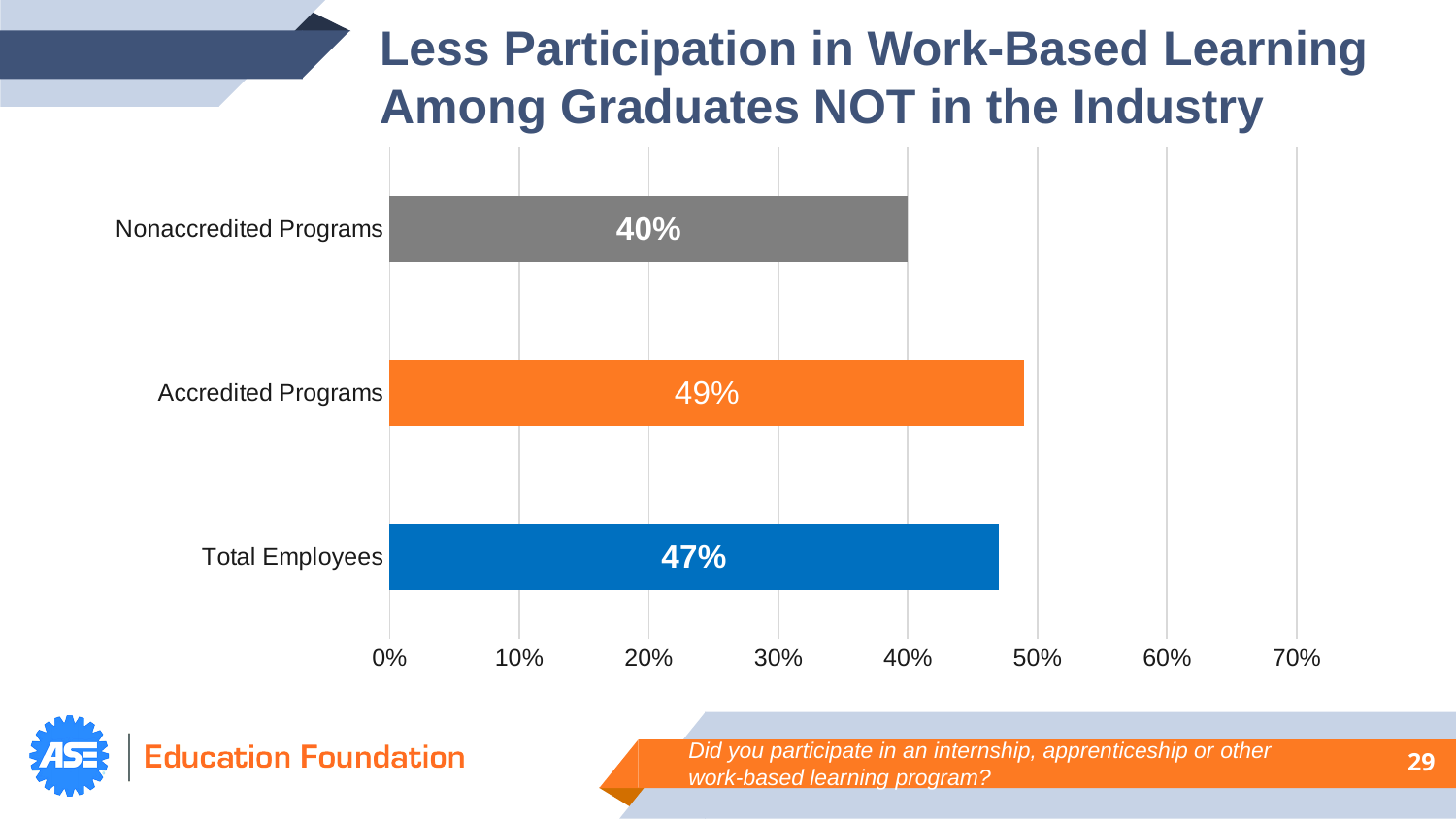
Which is larger, the value for Accredited Programs or Total Employees? Accredited Programs Which category has the lowest value? Nonaccredited Programs What is the value for Accredited Programs? 49% What is the difference between Total Employees and Nonaccredited Programs? 7% What is the value for Total Employees? 47% How many categories are shown in the chart? 3 Is the value for Total Employees greater or less than 50%? less What is the value for Nonaccredited Programs? 40% What is the difference between Accredited Programs and Nonaccredited Programs? 9% What colour is the bar for Accredited Programs? Orange Which category has the highest value? Accredited Programs What kind of chart is shown on the slide? Bar chart